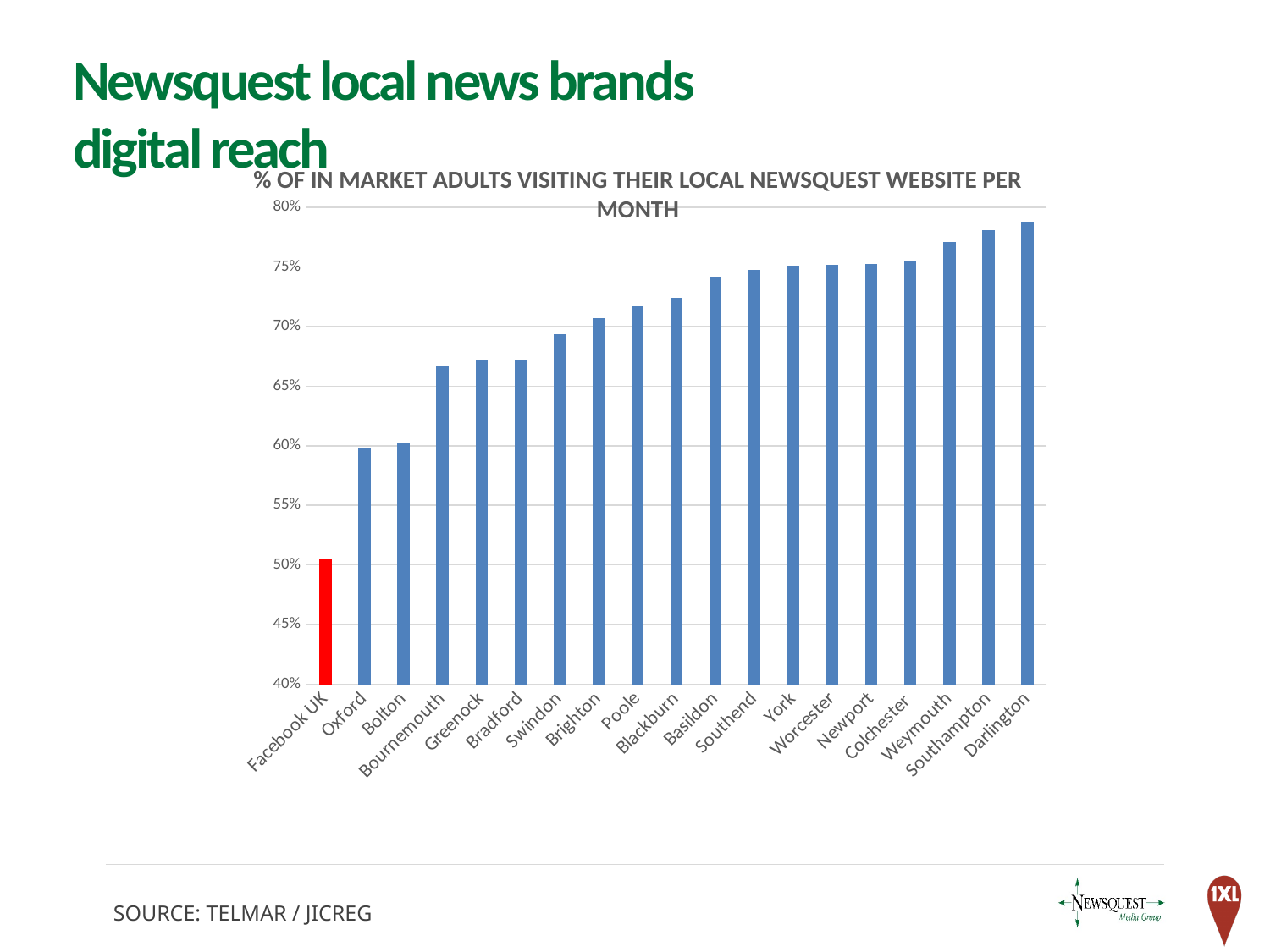
Do the values generally rise or fall moving from left to right along the x axis? rise Is the value for Facebook UK greater or less than 55%? less Which has the larger value, Oxford or Brighton? Brighton What is the title of the chart? % OF IN MARKET ADULTS VISITING THEIR LOCAL NEWSQUEST WEBSITE PER MONTH Is the value for Bournemouth greater or less than 65%? greater Is the value for Swindon greater or less than 70%? less Which bar in the chart is coloured red rather than blue? Facebook UK Which category has the lowest value in the chart? Facebook UK How many categories are plotted on the x axis of the chart? 19 What kind of chart is shown on the slide? bar chart Which category has the highest value in the chart? Darlington